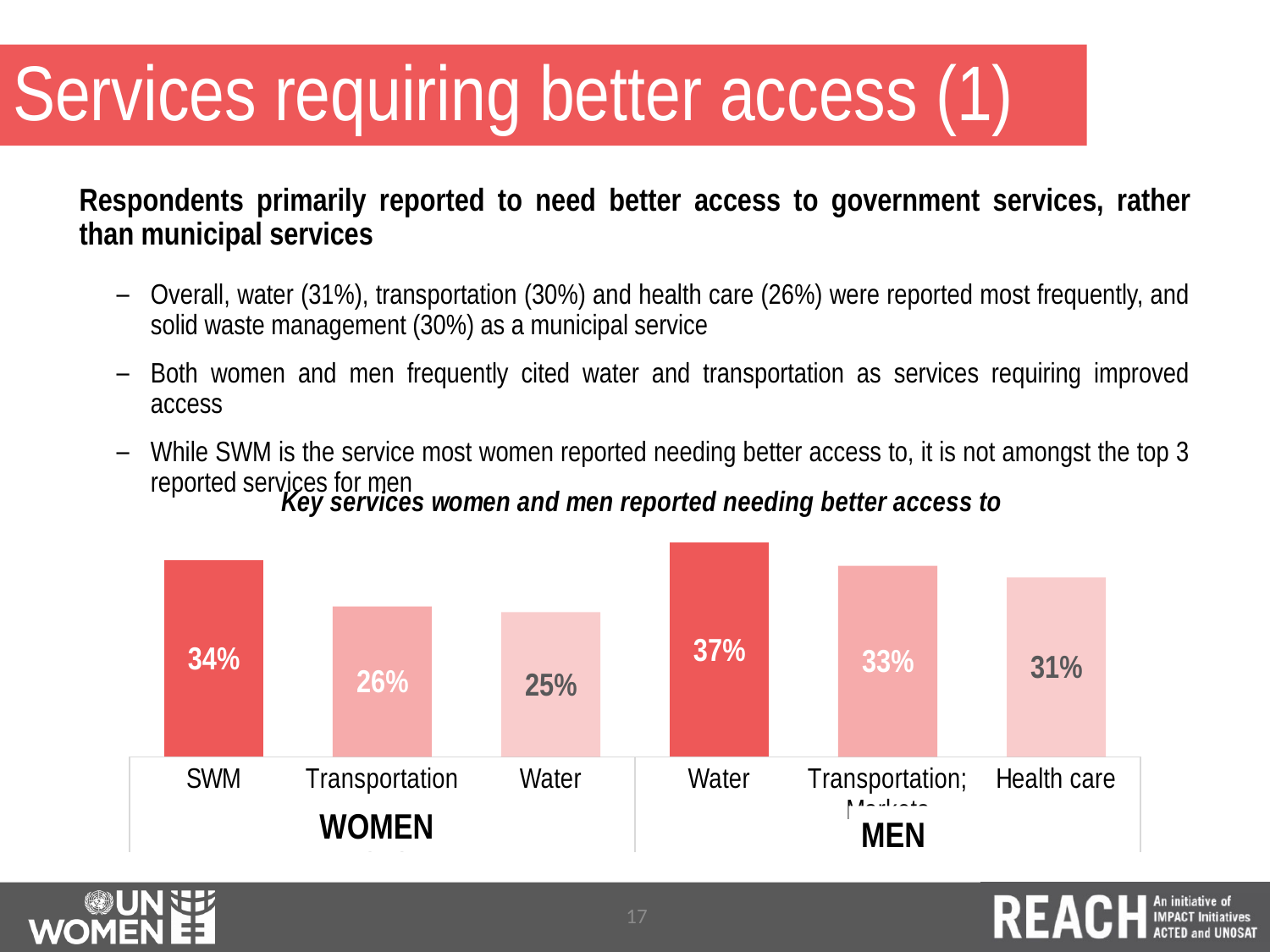
What percentage of women reported needing better access to Water? 25% Which service has the lowest value among the men's bars? Health care What percentage of men reported needing better access to Health care? 31% What is the difference between the women's SWM value and the women's Transportation value? 8% Which service has the highest value among the women's bars? SWM What is the difference between the men's Water value and the women's Water value? 12% What type of chart is shown on the slide? Bar chart What is the title of the chart? Key services women and men reported needing better access to Which is larger: the women's Transportation value or the men's Transportation value? Men's Transportation What percentage of women reported needing better access to SWM? 34% What percentage of men reported needing better access to Water? 37% How many bars are shown in the chart in total? 6